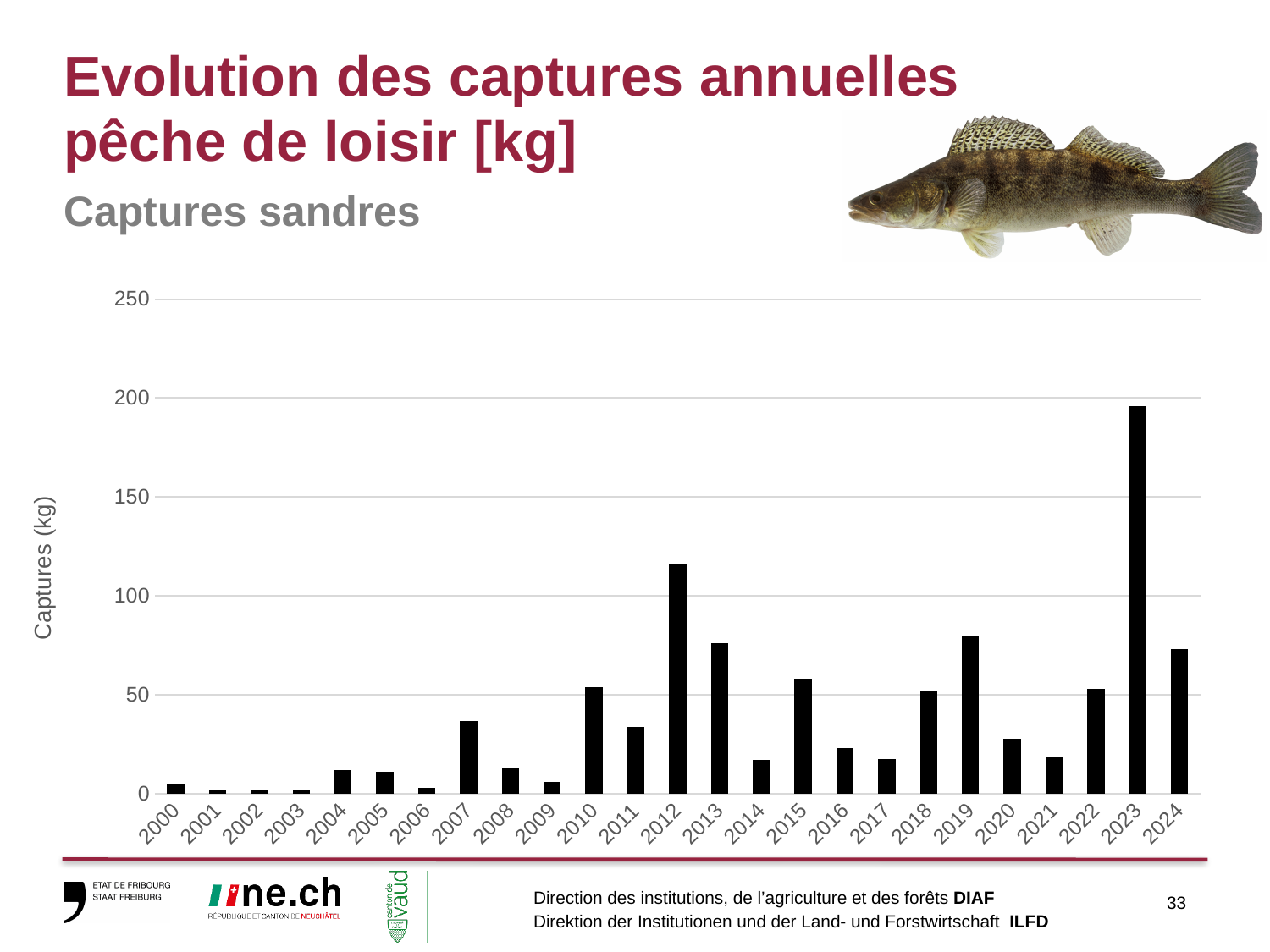
Which year has the larger value, 2012 or 2013? 2012 How many years are shown on the x axis of the chart? 25 Which year has the highest value for sandre captures? 2023 Is the value for 2019 greater or less than 100? less What is the label of the y axis? Captures (kg) Is the value for 2023 greater or less than 150? greater Is the value for 2010 greater or less than 50? greater What is the subtitle of the chart shown on the slide? Captures sandres Which year has the larger value, 2016 or 2019? 2019 What kind of chart is shown on the slide? bar chart